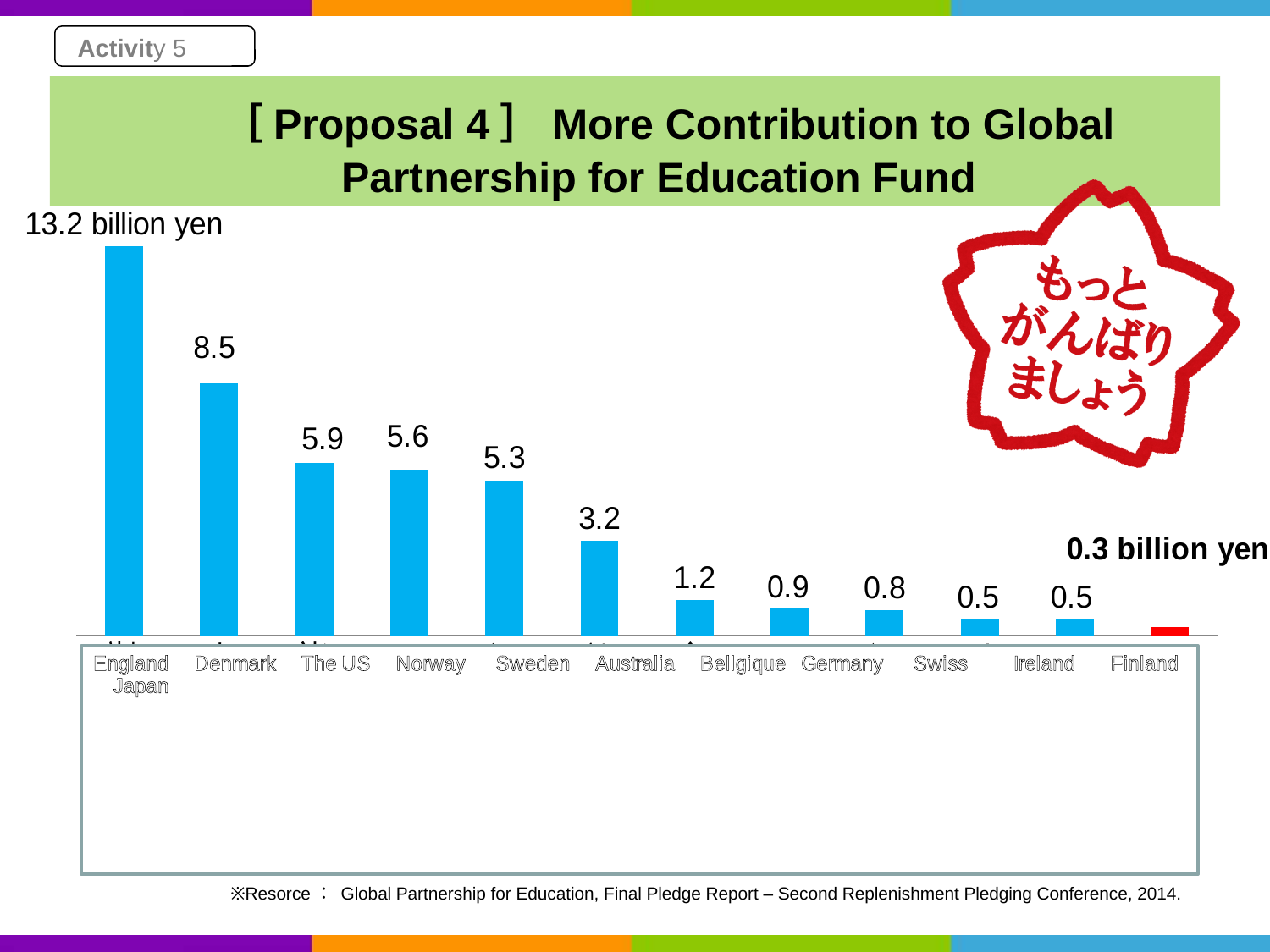
What kind of chart is shown on the slide? bar chart What is the value shown for the red bar (Japan)? 0.3 billion yen Do the values rise or fall from left to right across the chart? fall What is the value shown for Denmark? 8.5 What colour is the bar for Japan? red Which country has the highest contribution in the chart? England What is the value shown for England? 13.2 billion yen How many bars are plotted in the chart? 12 Which has a larger value, Norway or Sweden? Norway Which country has the lowest value in the chart? Japan What is the value shown for Australia? 3.2 What is the difference between the values for Denmark and The US? 2.6